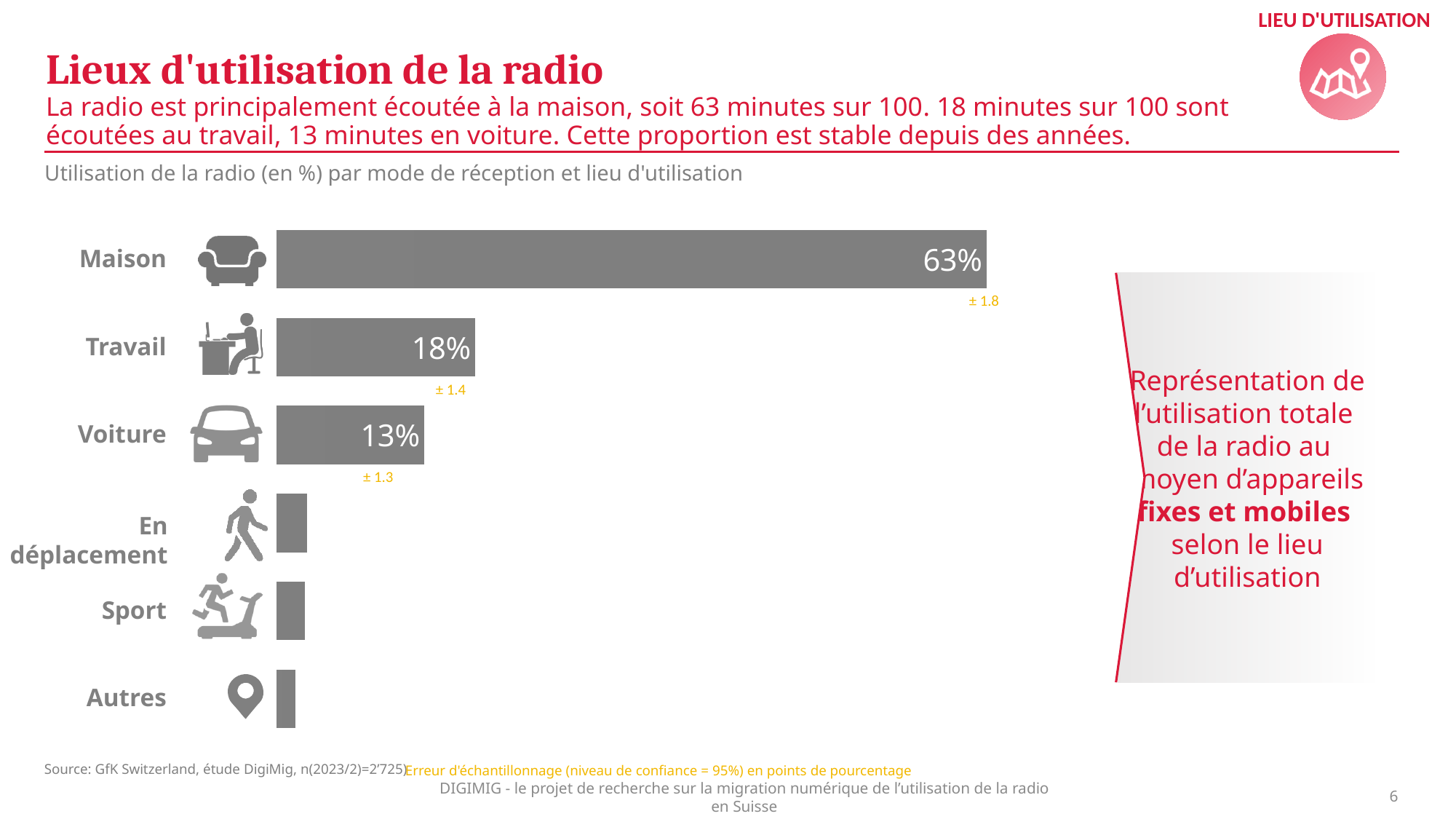
Which is larger, the value for Voiture or the value for Sport? Voiture Which category has the lowest value? Autres What is the difference between the values for Travail and Voiture? 5 percentage points Which is larger, the value for En déplacement or the value for Autres? En déplacement What is the sampling error shown for the Maison bar? ± 1.8 What is the value for Voiture? 13% What kind of chart is shown on the slide? Bar chart Which category has the highest value? Maison What is the difference between the values for Maison and Travail? 45 percentage points What is the value for Maison? 63% What is the value for Travail? 18% How many categories are shown in the chart? 6